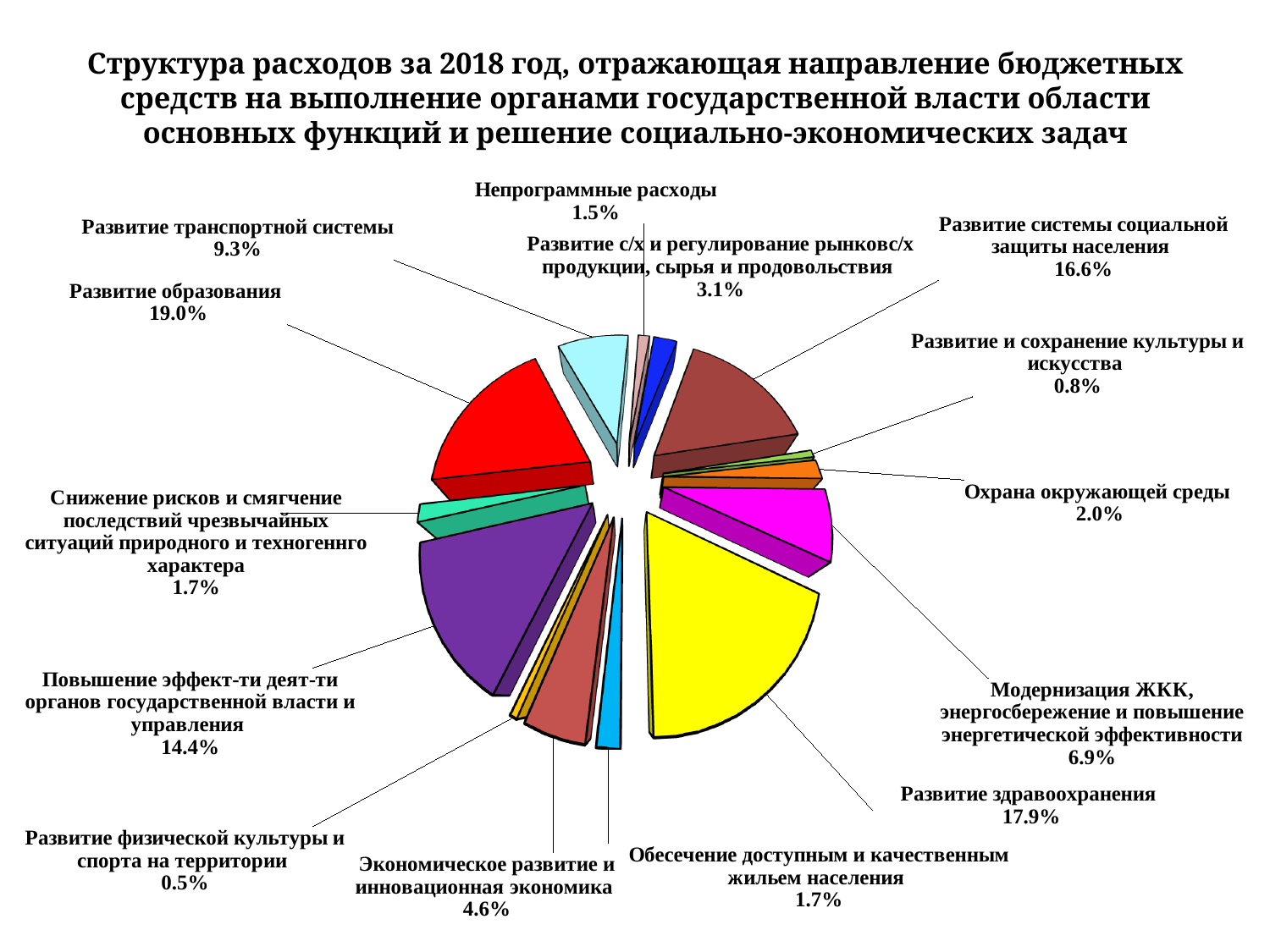
What is the value shown for Развитие здравоохранения? 17.9% What share is labelled for Охрана окружающей среды? 2.0% What is the difference between Развитие системы социальной защиты населения and Повышение эффект-ти деят-ти органов государственной власти и управления? 2.2 percentage points What is the difference in percentage points between Развитие образования and Развитие здравоохранения? 1.1 percentage points Which is larger: Развитие транспортной системы or Модернизация ЖКК, энергосбережение и повышение энергетической эффективности? Развитие транспортной системы What type of chart is shown on the slide? Pie chart How many categories are shown in the pie chart? 14 Which category has the smallest share of the pie? Развитие физической культуры и спорта на территории What share of expenditures does Развитие образования account for? 19.0% What percentage is shown for Модернизация ЖКК, энергосбережение и повышение энергетической эффективности? 6.9% Which category has the largest share of the pie? Развитие образования What year does the chart title say the expenditure structure refers to? 2018